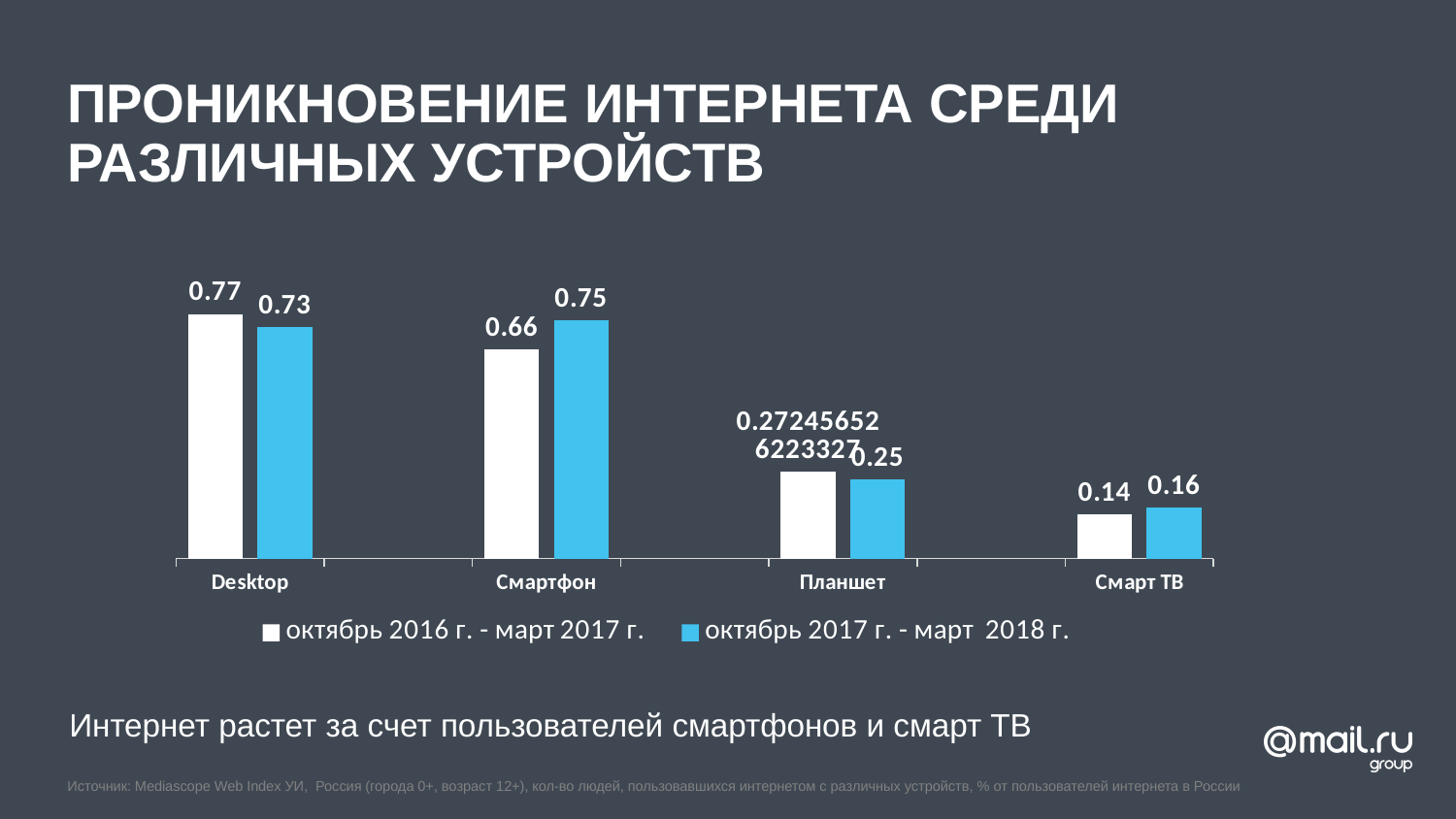
How many series does the chart legend list? 2 What is the value for Desktop in the series 'октябрь 2016 г. - март 2017 г.'? 0.77 Which device category has the lowest value in the series 'октябрь 2017 г. - март 2018 г.'? Смарт ТВ What is the value for Планшет in the series 'октябрь 2017 г. - март 2018 г.'? 0.25 What is the value for Смартфон in the series 'октябрь 2017 г. - март 2018 г.'? 0.75 Which colour represents the series 'октябрь 2017 г. - март 2018 г.' in the chart? Blue By how much did the value for Смартфон increase from 'октябрь 2016 г. - март 2017 г.' to 'октябрь 2017 г. - март 2018 г.'? 0.09 How many device categories are shown on the x axis of the chart? 4 Which device category has the highest value in the series 'октябрь 2016 г. - март 2017 г.'? Desktop What is the value for Смарт ТВ in the series 'октябрь 2016 г. - март 2017 г.'? 0.14 For Desktop, which series has the larger value: 'октябрь 2016 г. - март 2017 г.' or 'октябрь 2017 г. - март 2018 г.'? октябрь 2016 г. - март 2017 г. What type of chart is shown on the slide? Bar chart